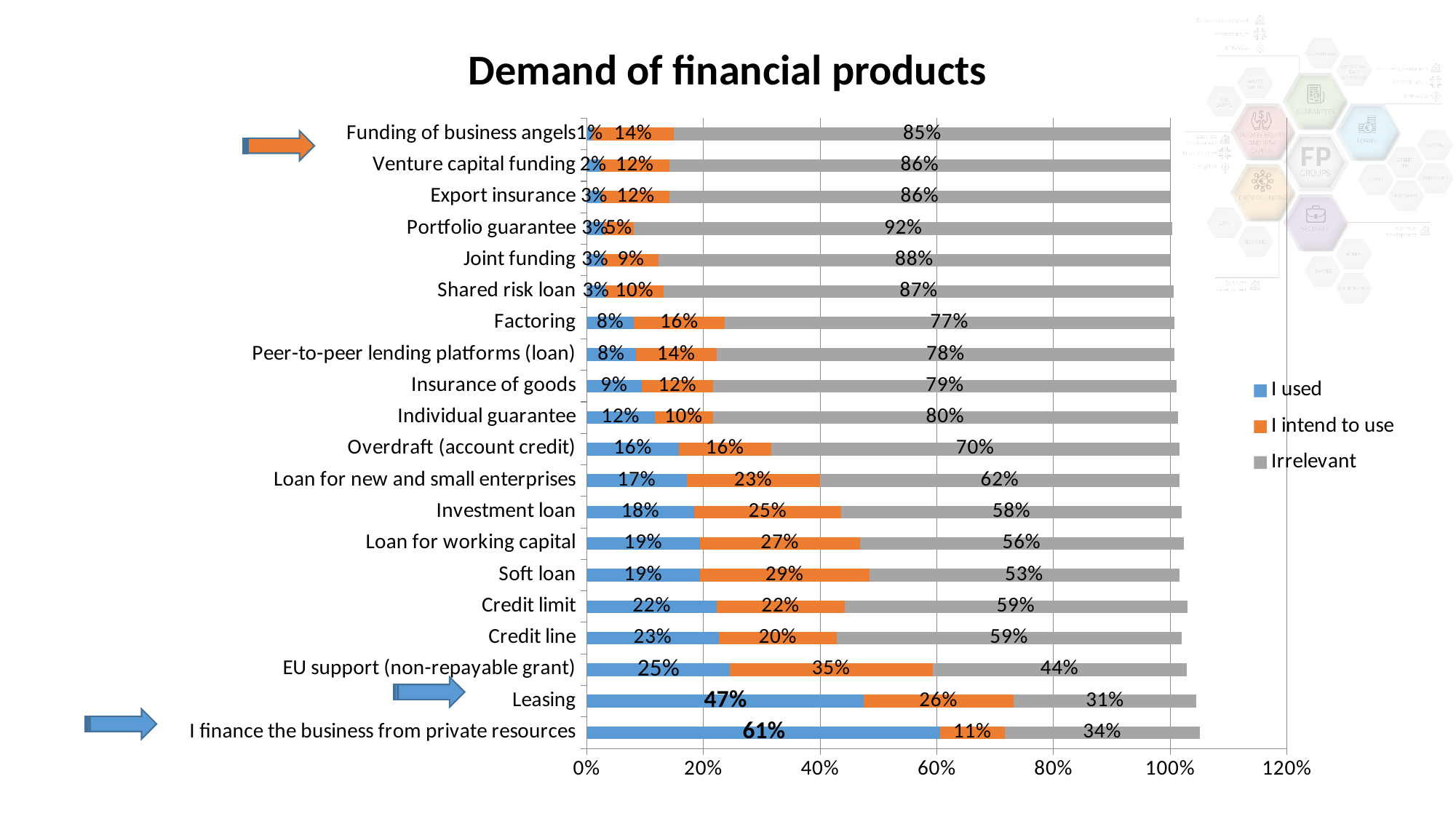
What is the 'I used' value for Credit line? 23% Which has a larger 'I intend to use' value, Soft loan or Investment loan? Soft loan What type of chart is shown on the slide? Stacked bar chart How many financial products (categories) are listed on the chart? 20 Which category has the highest 'I used' value? I finance the business from private resources What percentage of respondents said they used leasing? 47% Which category has the lowest 'I used' value? Funding of business angels What is the difference between the 'I used' values for I finance the business from private resources and Leasing? 14% What is the 'I intend to use' value for EU support (non-repayable grant)? 35% How many series does the legend list? 3 Which category has the highest 'I intend to use' value? EU support (non-repayable grant) What is the 'Irrelevant' value for Portfolio guarantee? 92%